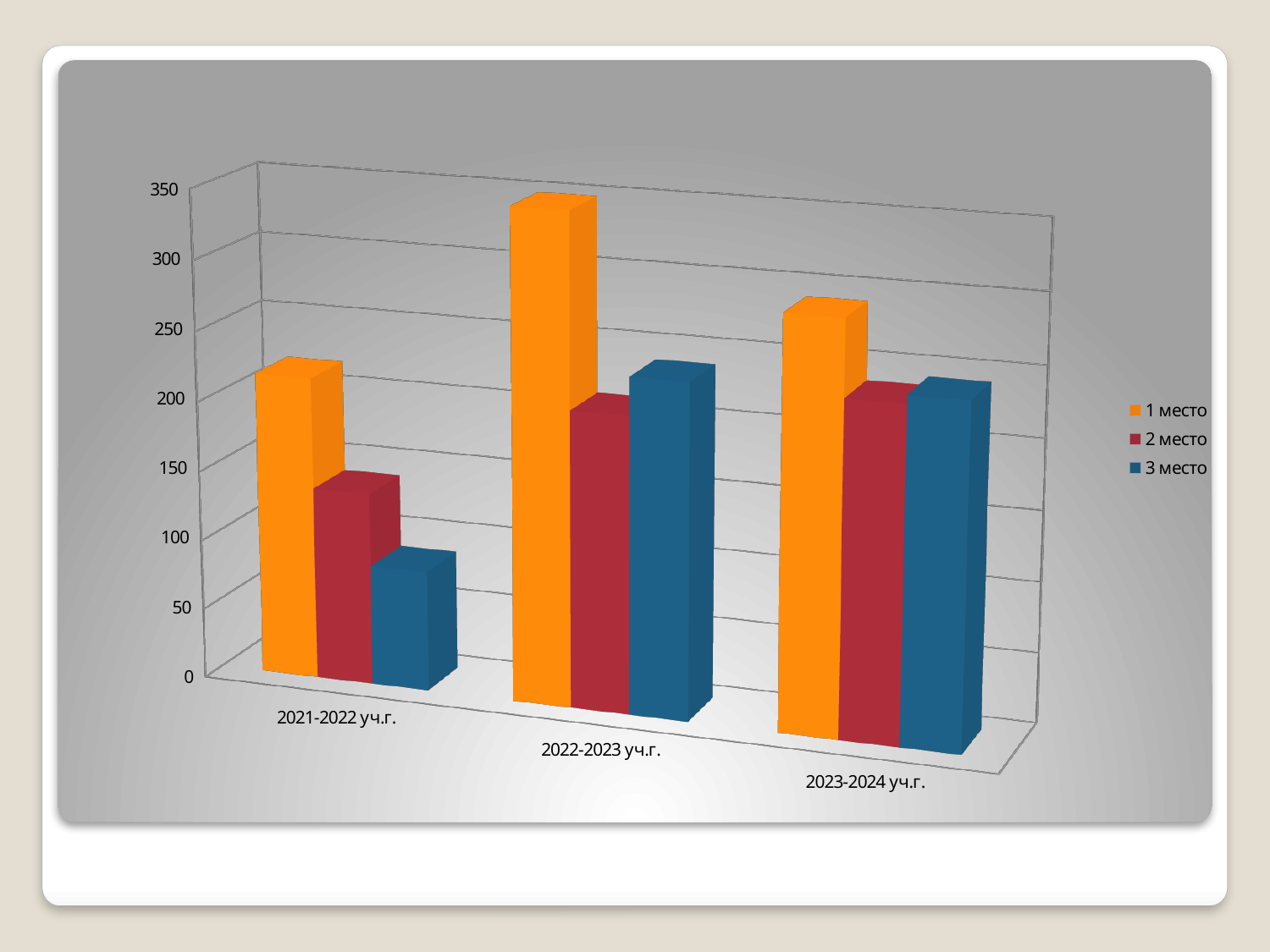
How many categories (academic years) are shown on the x axis? 3 What type of chart is shown on the slide? Bar chart Is the value for 2 место in 2021-2022 уч.г. greater or less than 150? less Which is larger for 1 место: 2022-2023 уч.г. or 2023-2024 уч.г.? 2022-2023 уч.г. Is the value for 3 место in 2021-2022 уч.г. greater or less than 100? less In 2022-2023 уч.г., which is larger: 2 место or 3 место? 3 место In which academic year is the value for 1 место the highest? 2022-2023 уч.г. Which colour represents the series 1 место in the legend? Orange How many series does the legend list? 3 Is the value for 1 место in 2022-2023 уч.г. greater or less than 300? greater In which academic year is the value for 3 место the lowest? 2021-2022 уч.г. Which series has the lowest value in 2021-2022 уч.г.? 3 место